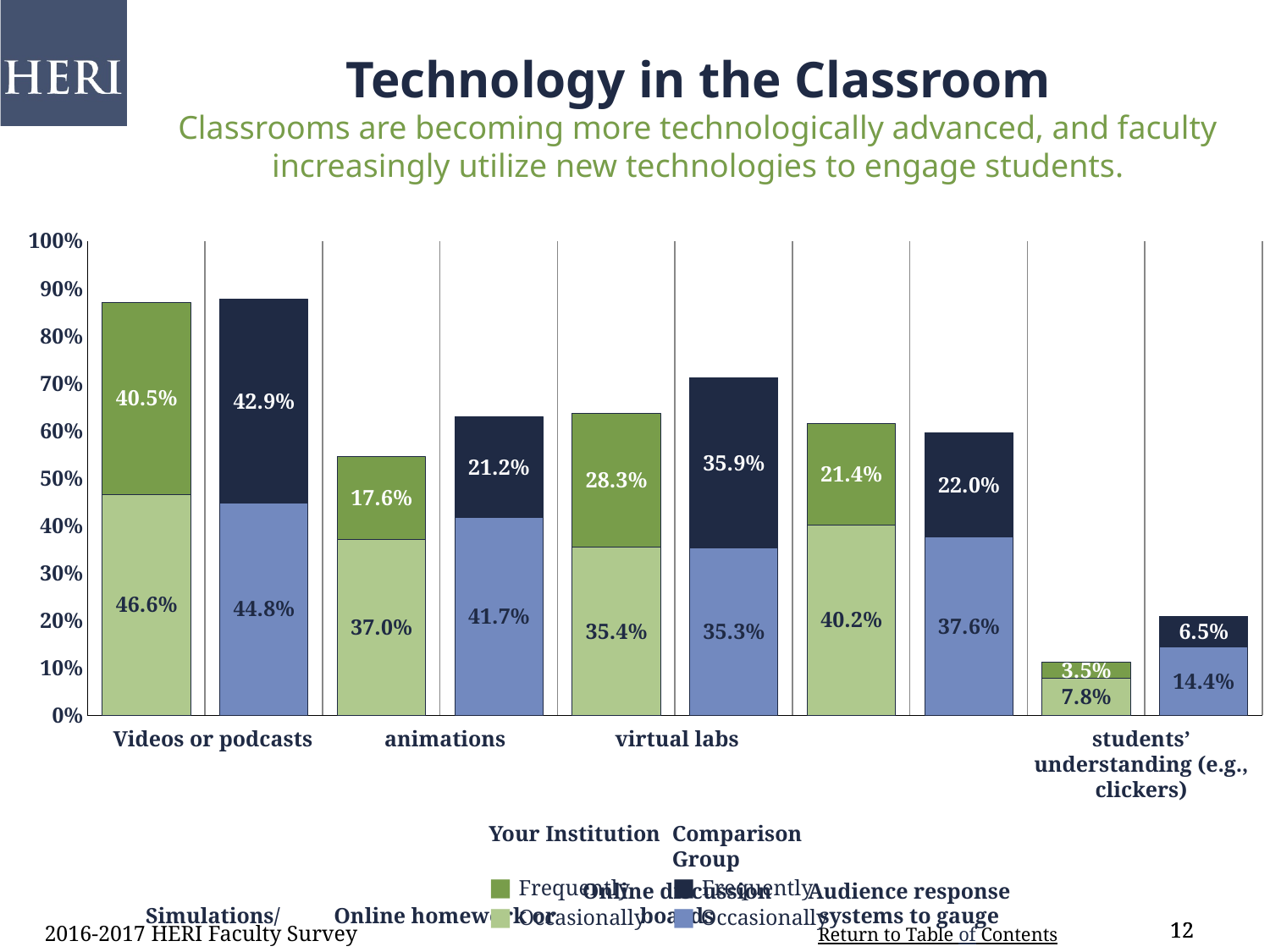
What percentage of the Comparison Group uses videos or podcasts occasionally? 44.8% What type of chart is shown on the slide? Stacked bar chart How many series does the legend list? 4 Which colour represents the Comparison Group's 'Frequently' series? Dark navy What is the total percentage (frequently plus occasionally) for the Comparison Group for clickers? 20.9% What is the total percentage (frequently plus occasionally) for Your Institution for videos or podcasts? 87.1% Which technology category has the lowest 'Frequently' value for Your Institution? Audience response systems (e.g., clickers) What percentage of the Comparison Group frequently uses audience response systems (e.g., clickers)? 6.5% How many technology categories are shown along the x axis? 5 For animations, which is larger: Your Institution's 'Occasionally' value or the Comparison Group's 'Occasionally' value? Comparison Group (41.7%) What percentage of faculty at Your Institution use videos or podcasts frequently? 40.5% What is the difference between the Comparison Group's and Your Institution's 'Frequently' values for virtual labs? 7.6%